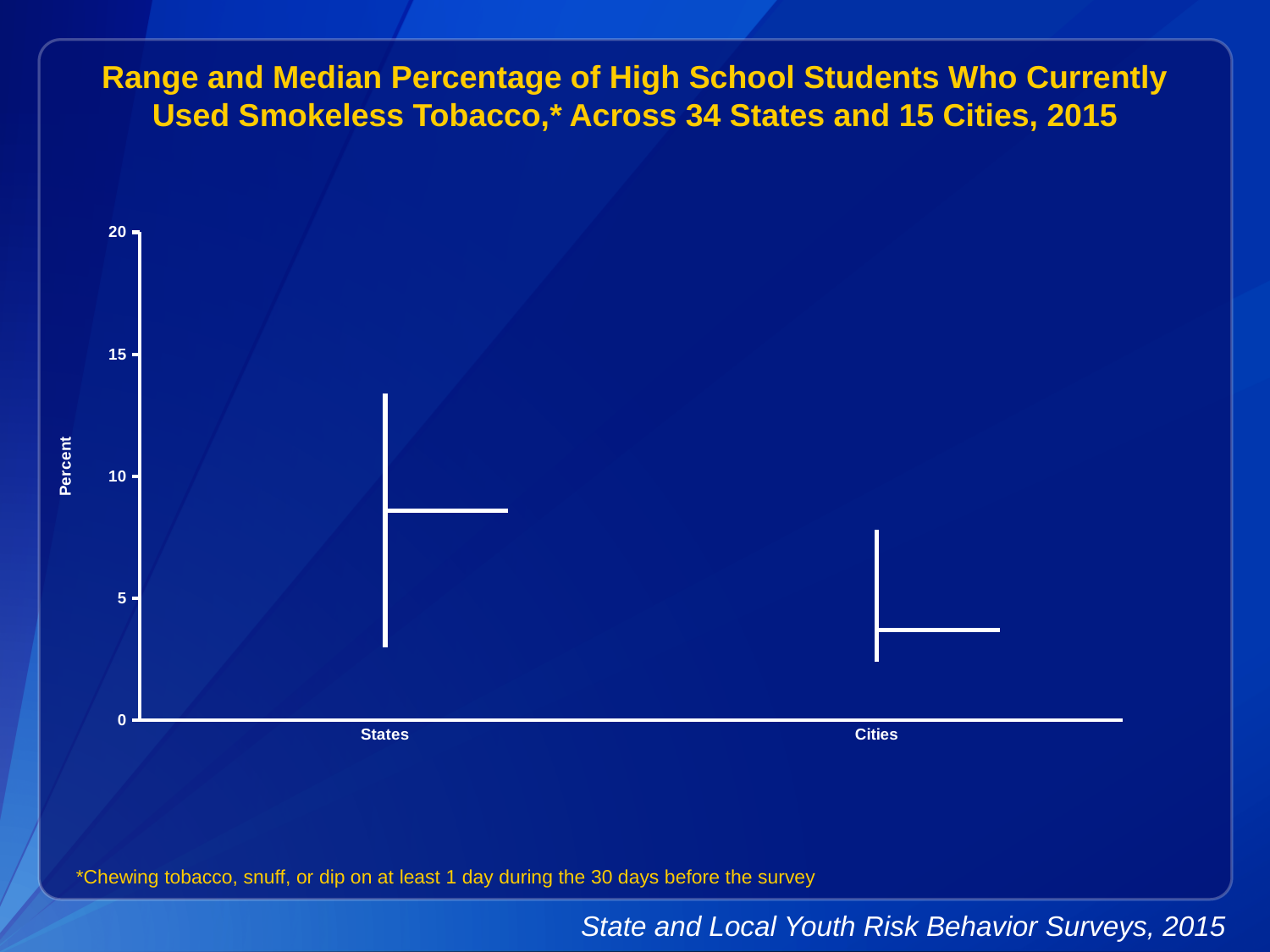
What is the highest value shown on the y axis? 20 Is the median value for Cities greater or less than 5? less Is the top of the range for Cities greater or less than 10? less Which category has the lower minimum (bottom of range) value? Cities Is the median value for States greater or less than 5? greater Which category has the higher maximum (top of range) value? States How many categories are shown on the x axis of the chart? 2 What is the label on the y axis of the chart? Percent Which category has the higher median percentage, States or Cities? States